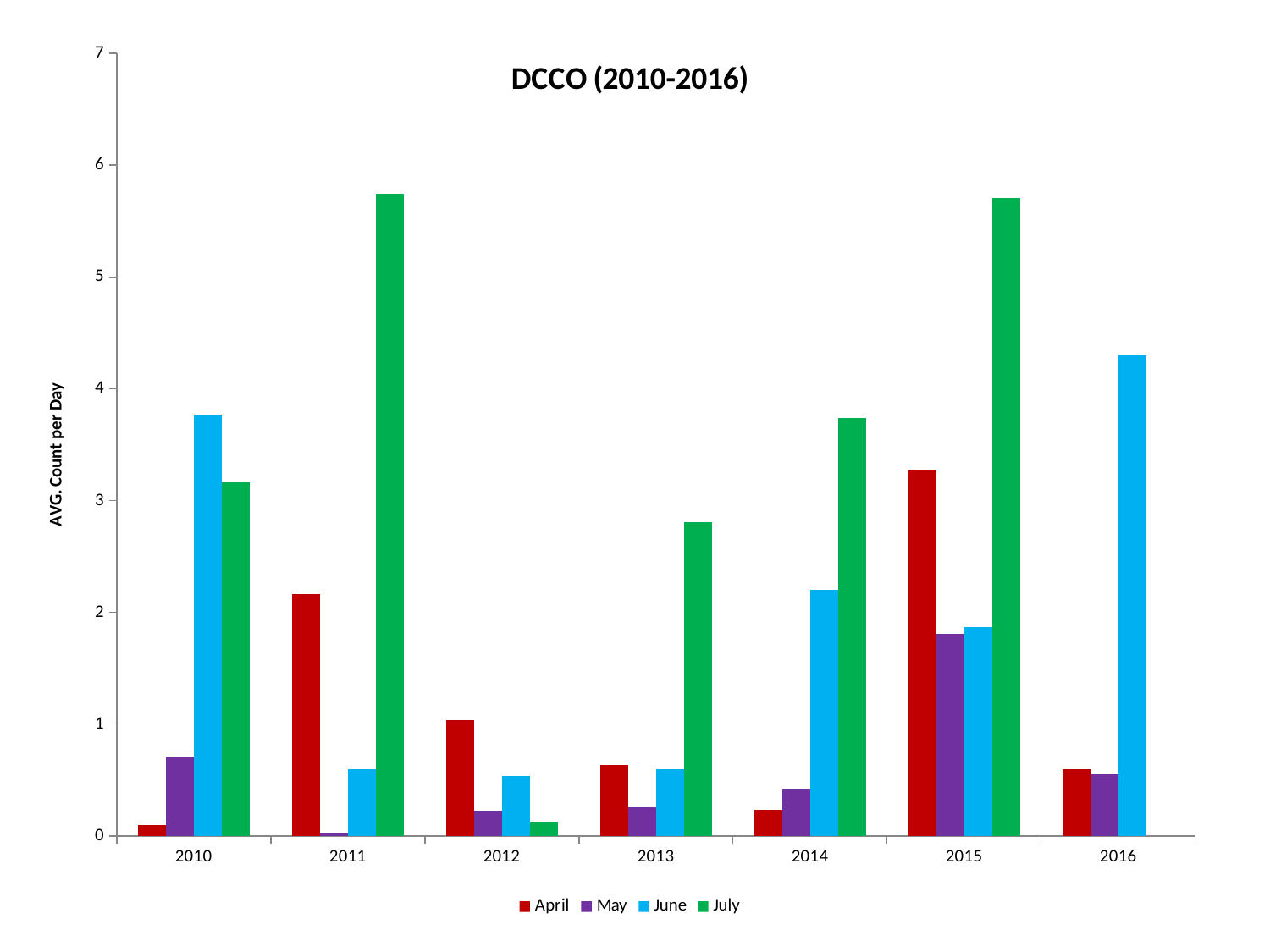
What is the title of the chart? DCCO (2010-2016) What is the label on the vertical axis? AVG. Count per Day In which year is the May value lowest? 2011 Is the value for April in 2015 greater or less than 3? greater Does the July value rise or fall from 2012 to 2015? rise What kind of chart is shown on the slide? bar chart In 2010, which is larger, the June value or the July value? June How many series does the legend list? 4 In which year is the June value highest? 2016 Is the value for July in 2012 greater or less than 1? less How many years are shown on the x axis? 7 Is the value for June in 2016 greater or less than 4? greater